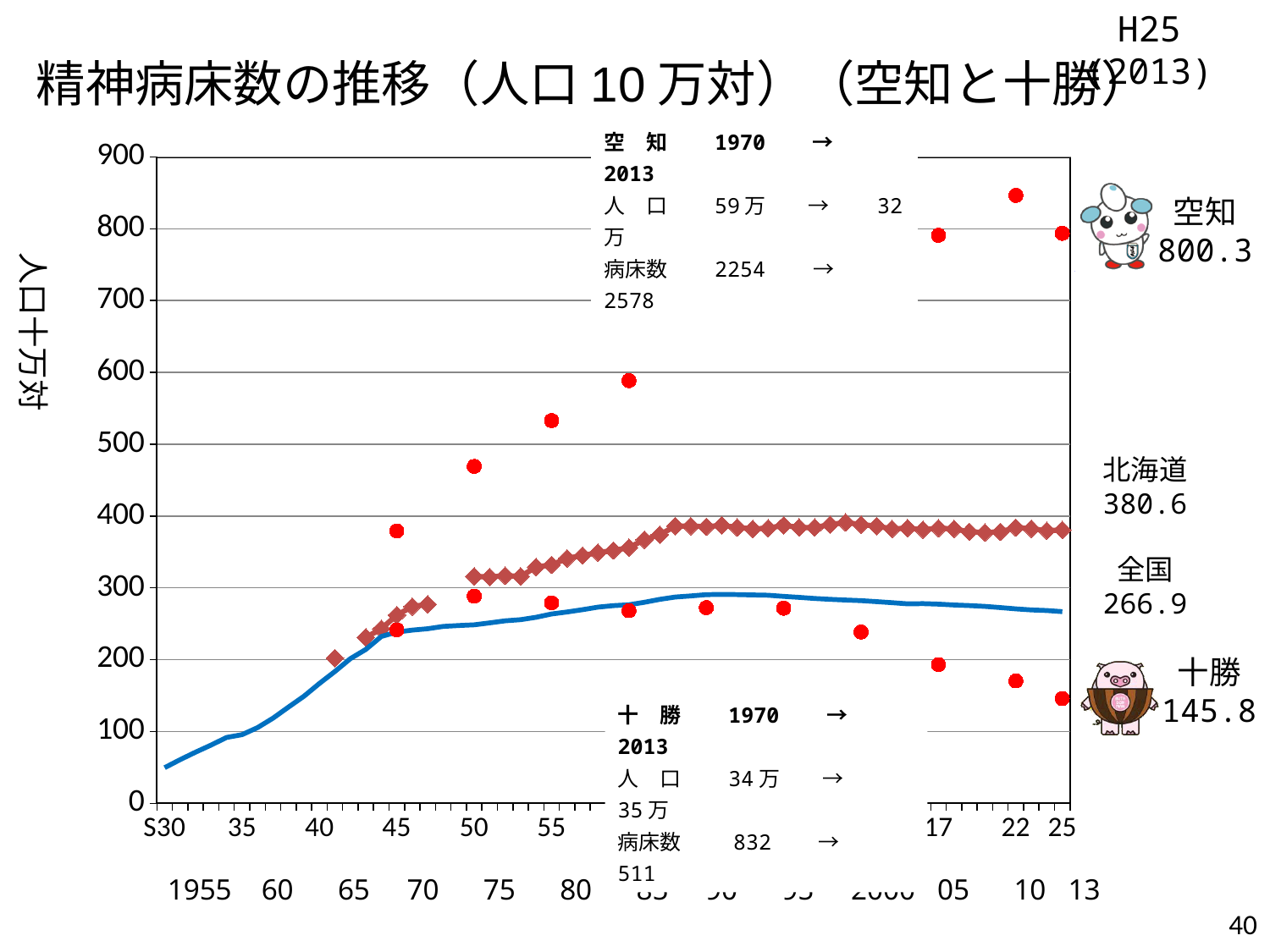
Which region has the highest value in 2013 on the chart? 空知 Do the values for 十勝 rise or fall from 1990 to 2013? fall What is the 2013 value shown for 空知 on the chart? 800.3 In 2013, which is larger, the value for 北海道 or the value for 全国? 北海道 How many series are plotted on the chart? 4 What is the 2013 value shown for 北海道 on the chart? 380.6 What is the difference between the 2013 values for 空知 and 十勝? 654.5 What is the label on the vertical axis of the chart? 人口十万対 Which region has the lowest value in 2013 on the chart? 十勝 Is the value for 空知 in 1985 (S60) greater or less than 500? greater What is the 2013 value shown for 十勝 on the chart? 145.8 What is the 2013 value shown for 全国 on the chart? 266.9